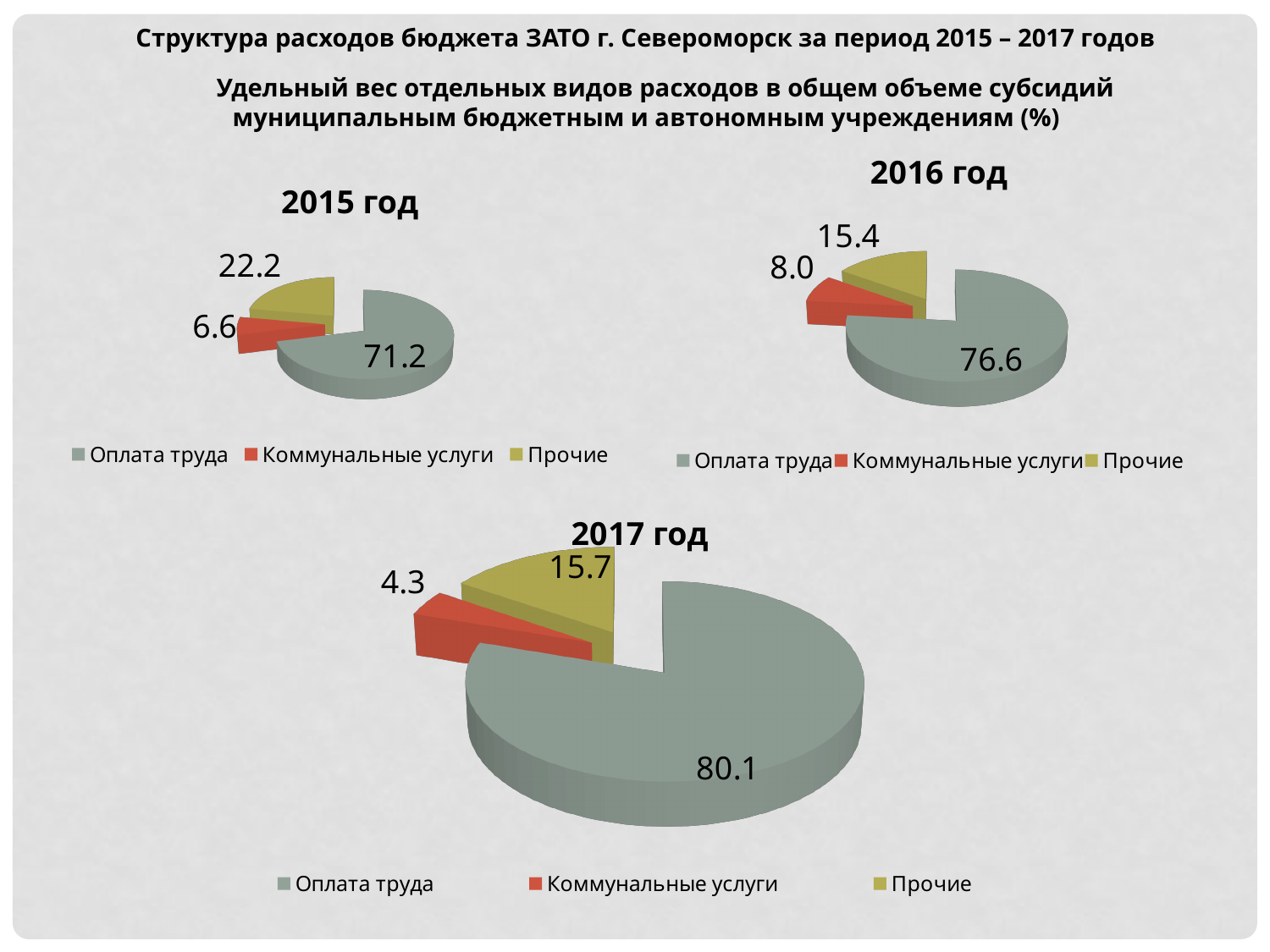
In the "2017 год" pie chart, which category has the largest slice? Оплата труда In the "2016 год" pie chart, what is the value for Коммунальные услуги? 8.0 In the "2017 год" pie chart, what is the value for Прочие? 15.7 In the "2017 год" pie chart, what colour is the Оплата труда slice? Grey-green In the "2015 год" pie chart, which category has the smallest slice? Коммунальные услуги What kind of chart is the "2015 год" chart? Pie chart In the "2016 год" pie chart, what is the difference between the values for Прочие and Коммунальные услуги? 7.4 How many series does the legend of the "2016 год" chart list? 3 In the "2015 год" pie chart, what is the value for Оплата труда? 71.2 How many slices does the "2017 год" pie chart have? 3 In the "2015 год" pie chart, which is larger: Прочие or Коммунальные услуги? Прочие